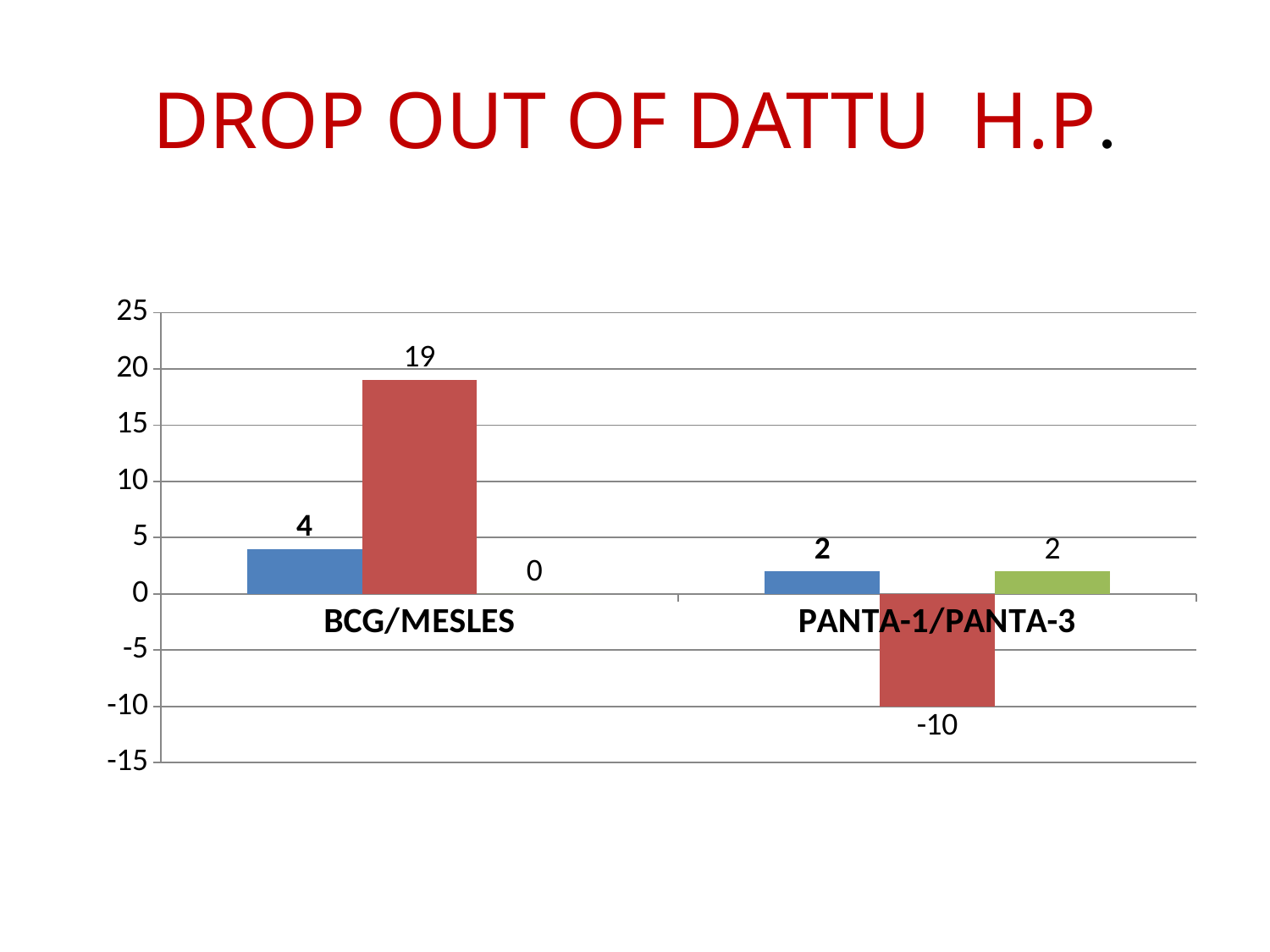
What is the difference between the red bar and the blue bar for BCG/MESLES? 15 Which bar has the lowest value on the chart? The red bar for PANTA-1/PANTA-3 (-10) What is the value of the red bar for PANTA-1/PANTA-3? -10 What is the value of the blue bar for BCG/MESLES? 4 How many categories are shown on the x axis? 2 What is the title of the slide? DROP OUT OF DATTU H.P. What is the value of the green bar for BCG/MESLES? 0 What is the value of the red bar for BCG/MESLES? 19 What kind of chart is shown on the slide? Bar chart What is the value of the green bar for PANTA-1/PANTA-3? 2 Which is larger, the blue bar for BCG/MESLES or the blue bar for PANTA-1/PANTA-3? BCG/MESLES Which bar has the highest value on the chart? The red bar for BCG/MESLES (19)